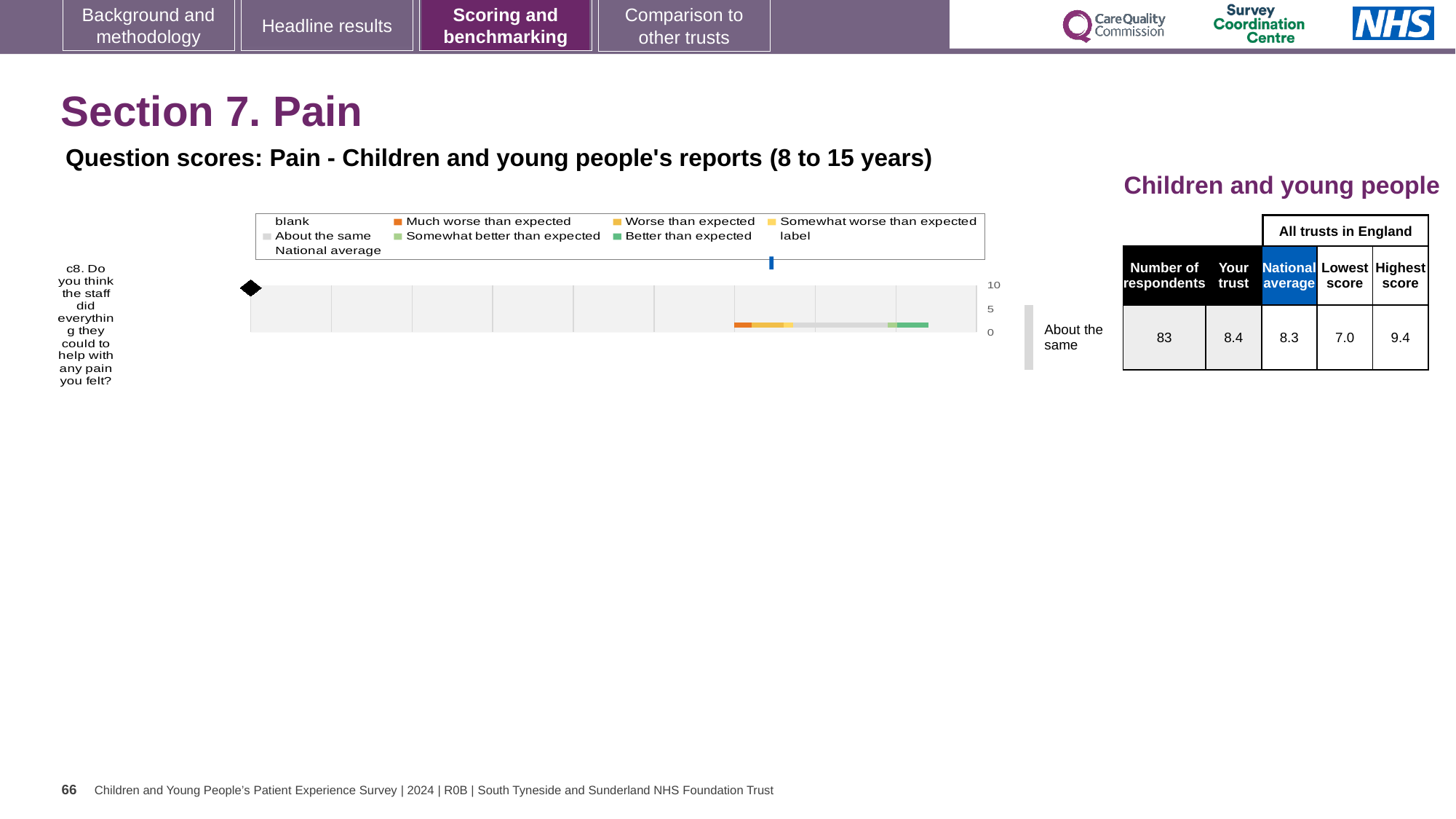
What is the national average score for question c8? 8.3 What is the title of the chart? Question scores: Pain - Children and young people's reports (8 to 15 years) How many respondents answered question c8? 83 How many survey questions (categories) are plotted in the chart? 1 How many entries does the chart legend list? 9 What is the lowest score among all trusts in England for question c8? 7.0 What kind of chart is shown on the slide? Bar chart What is the benchmark category shown for question c8? About the same Which is larger for question c8, the 'Your trust' score or the national average? Your trust Which legend entry is shown in orange? Much worse than expected What is the highest score among all trusts in England for question c8? 9.4 What is the 'Your trust' score for question c8? 8.4